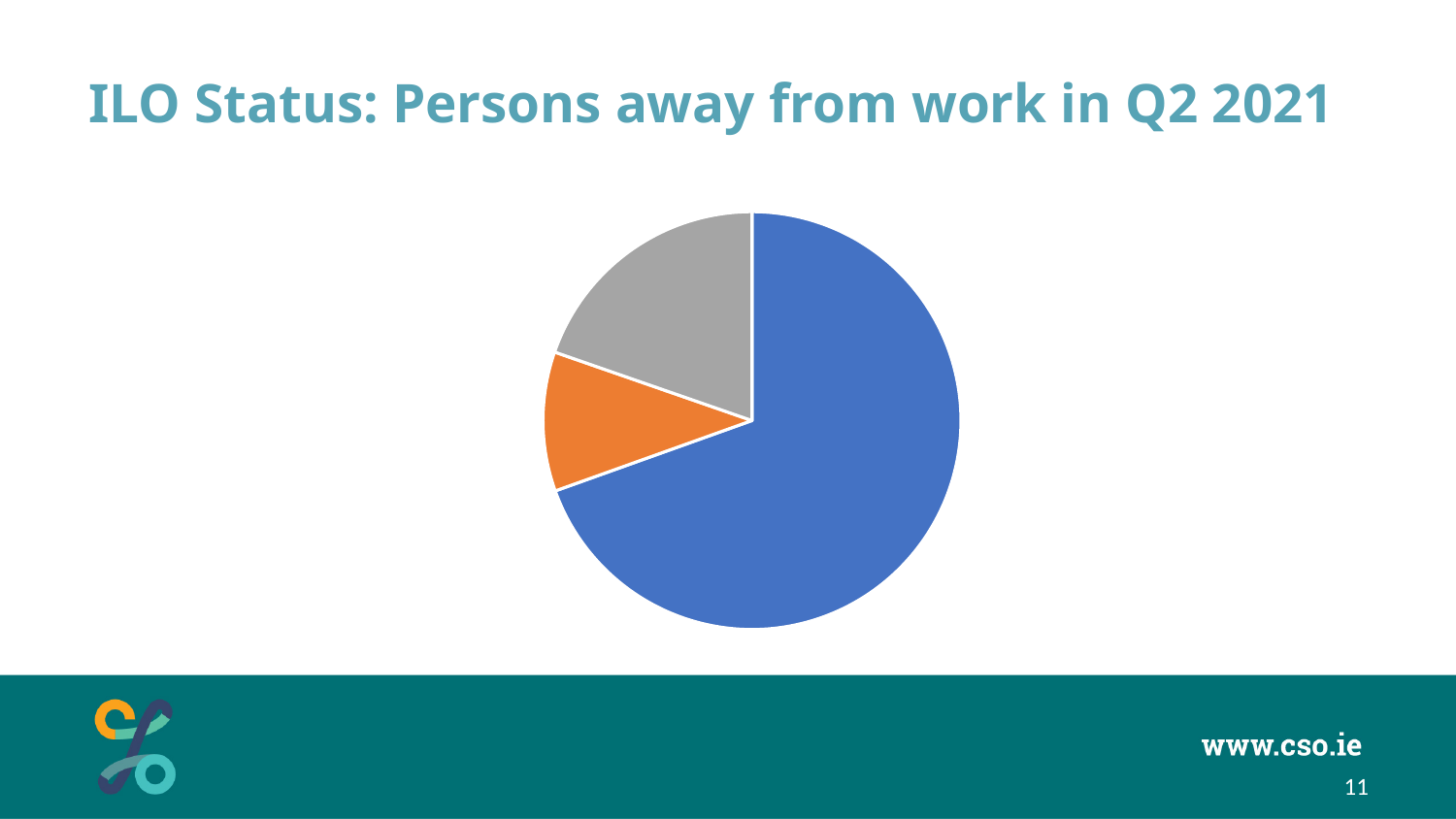
What is the title of the slide containing the pie chart? ILO Status: Persons away from work in Q2 2021 Which is larger, the blue slice or the grey slice? Blue Is the blue slice greater or less than half of the pie? greater Which colour slice is the smallest in the pie chart? Orange What kind of chart is shown on the slide? Pie chart Which quarter and year does the pie chart refer to? Q2 2021 Which colour slice is the largest in the pie chart? Blue How many slices does the pie chart have? 3 Is the orange slice greater or less than a quarter of the pie? less Which is larger, the grey slice or the orange slice? Grey